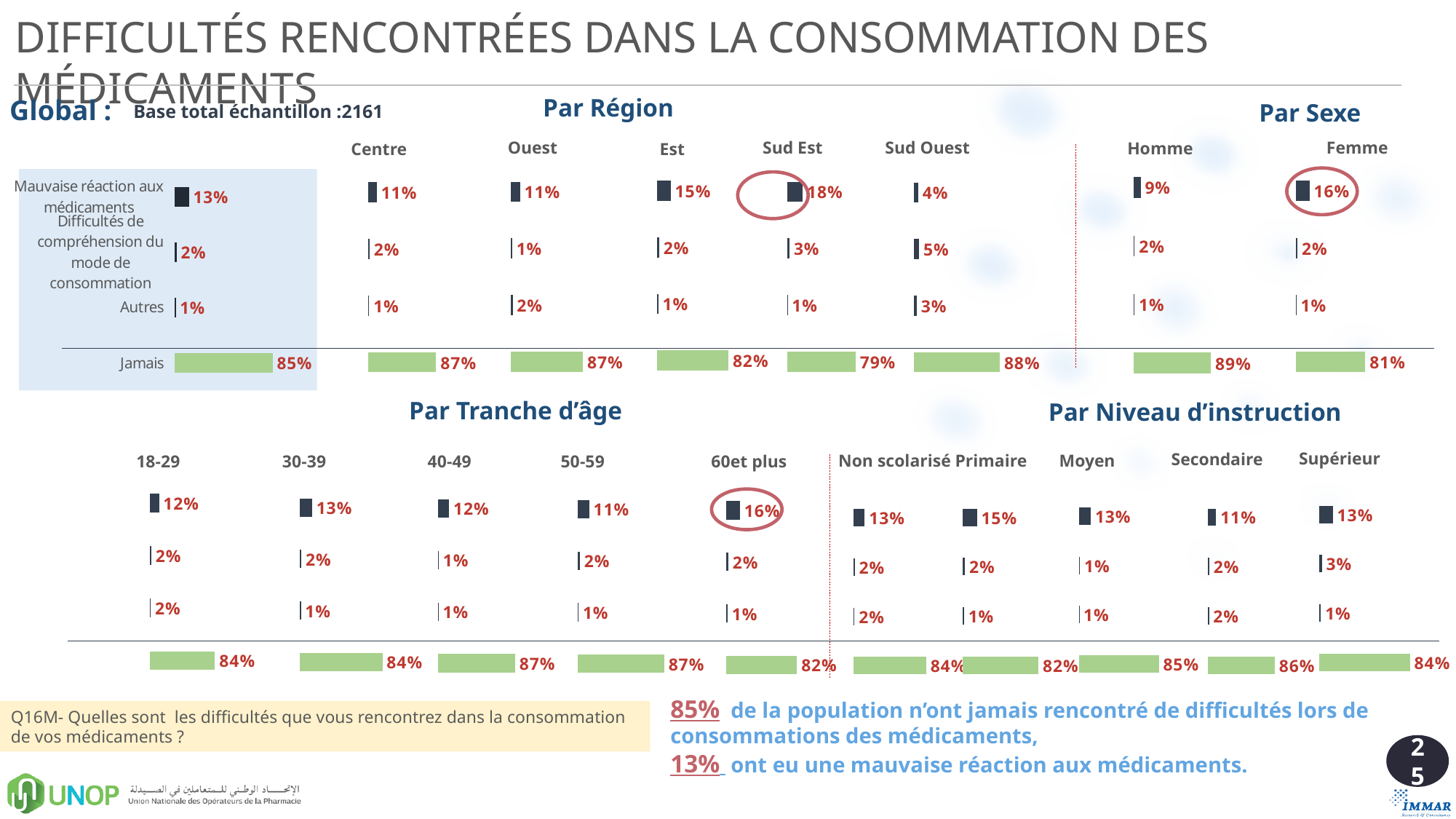
In the Par Tranche d'âge chart, which age group has the highest value for 'Mauvaise réaction aux médicaments'? 60et plus In the Global chart, what percentage of respondents reported a 'Mauvaise réaction aux médicaments'? 13% In the Par Sexe chart, what is the difference between Femme and Homme for 'Mauvaise réaction aux médicaments'? 7% In the Par Sexe chart, which has the higher 'Jamais' value, Homme or Femme? Homme In the Par Tranche d'âge chart, how many age groups are shown? 5 In the Par Niveau d'instruction chart, what is the 'Jamais' value for Secondaire? 86% In the Par Niveau d'instruction chart, what is the 'Mauvaise réaction aux médicaments' value for Primaire? 15% In the Par Région chart, which region has the lowest value for 'Mauvaise réaction aux médicaments'? Sud Ouest What is the base total sample size stated on the slide? 2161 In the Global chart, what is the value for 'Jamais'? 85% In the Par Région chart, what is the 'Jamais' value for Sud Est? 79% In the Par Région chart, which region has the highest value for 'Mauvaise réaction aux médicaments'? Sud Est